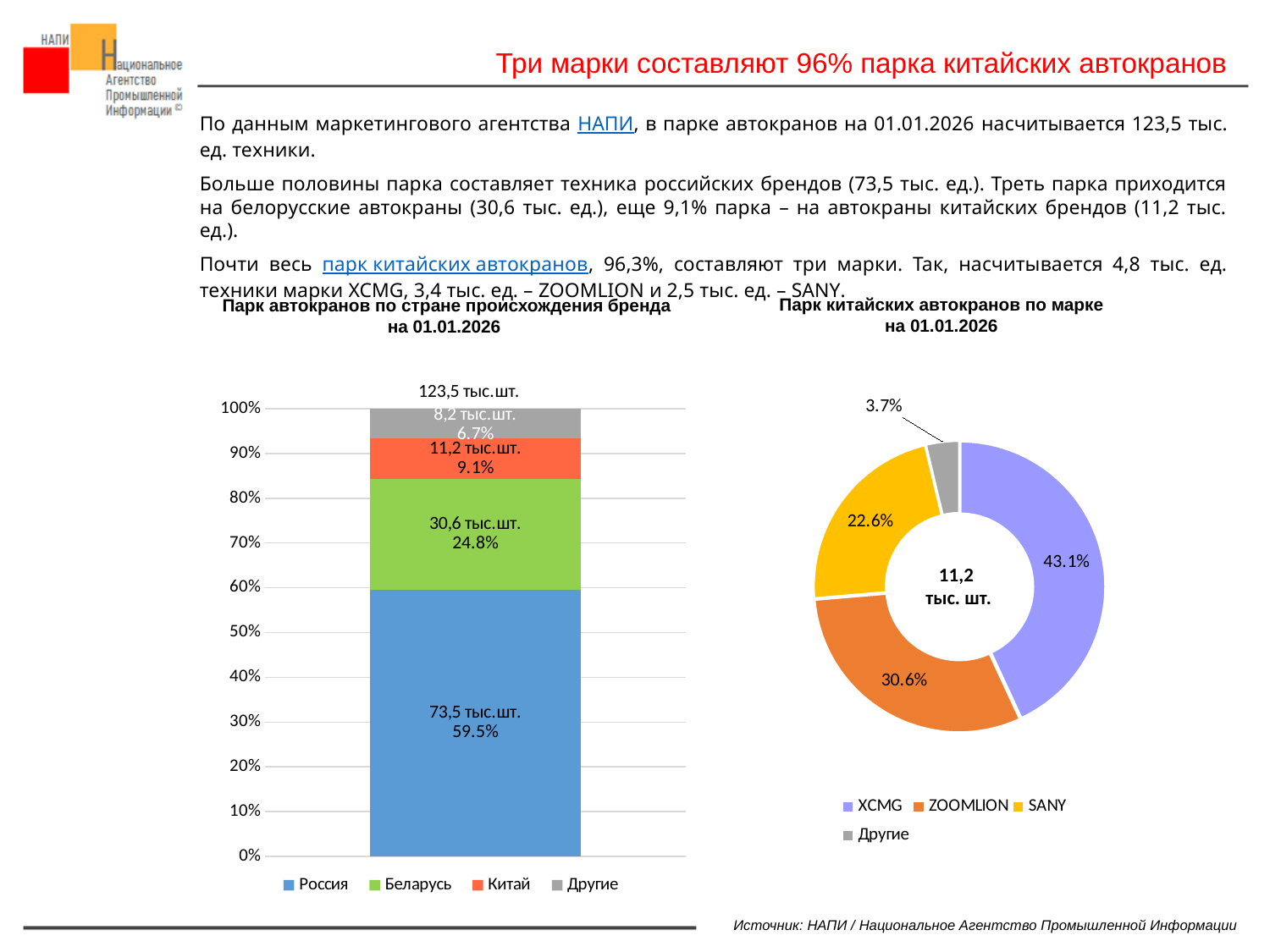
In the chart 'Парк автокранов по стране происхождения бренда на 01.01.2026', what value is shown for Китай? 11,2 тыс.шт. In the chart 'Парк китайских автокранов по марке на 01.01.2026', which is larger, SANY or Другие? SANY In the chart 'Парк автокранов по стране происхождения бренда на 01.01.2026', which category has the smallest share? Другие In the chart 'Парк китайских автокранов по марке на 01.01.2026', what total is shown in the centre of the doughnut? 11,2 тыс. шт. In the chart 'Парк автокранов по стране происхождения бренда на 01.01.2026', what is the total shown above the stacked bar? 123,5 тыс.шт. In the chart 'Парк автокранов по стране происхождения бренда на 01.01.2026', what is the difference in percentage points between Россия and Беларусь? 34.7 What type of chart is 'Парк китайских автокранов по марке на 01.01.2026'? Doughnut chart In the chart 'Парк китайских автокранов по марке на 01.01.2026', which brand has the largest share? XCMG In the chart 'Парк автокранов по стране происхождения бренда на 01.01.2026', what percentage share is shown for Беларусь? 24.8% In the chart 'Парк автокранов по стране происхождения бренда на 01.01.2026', how many series does the legend list? 4 In the chart 'Парк китайских автокранов по марке на 01.01.2026', what share is shown for ZOOMLION? 30.6% In the chart 'Парк автокранов по стране происхождения бренда на 01.01.2026', what value is shown for Россия? 73,5 тыс.шт.